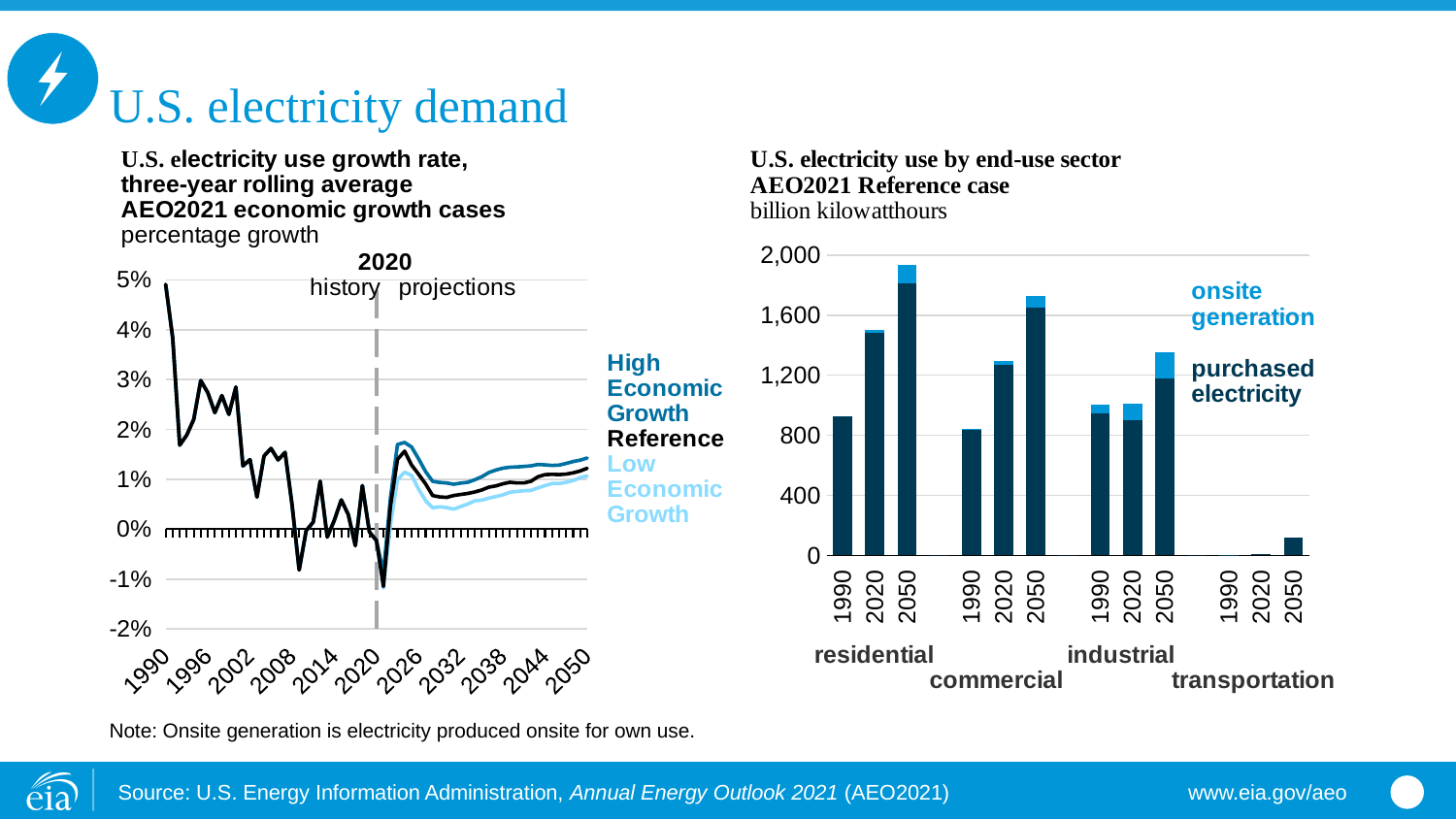
In the 'U.S. electricity use by end-use sector' chart, is the total for commercial in 1990 greater or less than 1,200 billion kilowatthours? less In the 'U.S. electricity use growth rate' chart, does the growth rate generally rise or fall between 1990 and 2020? fall In the 'U.S. electricity use by end-use sector' chart, is the total for transportation in 2050 greater or less than 400 billion kilowatthours? less In the 'U.S. electricity use growth rate' chart, which case has the highest growth rate in the projection years? High Economic Growth In the 'U.S. electricity use by end-use sector' chart, how many series does the legend list? 2 In the 'U.S. electricity use by end-use sector' chart, which sector and year has the tallest bar? residential, 2050 In the 'U.S. electricity use by end-use sector' chart, which sector has the lowest electricity use in every year shown? transportation What type of chart is the 'U.S. electricity use by end-use sector' chart on the right? bar chart In the 'U.S. electricity use by end-use sector' chart, is the total for residential in 2050 greater or less than 1,600 billion kilowatthours? greater In the 'U.S. electricity use by end-use sector' chart, how many end-use sectors are shown? 4 What type of chart is the 'U.S. electricity use growth rate' chart on the left? line chart In the 'U.S. electricity use growth rate' chart, how many economic growth cases are plotted? 3